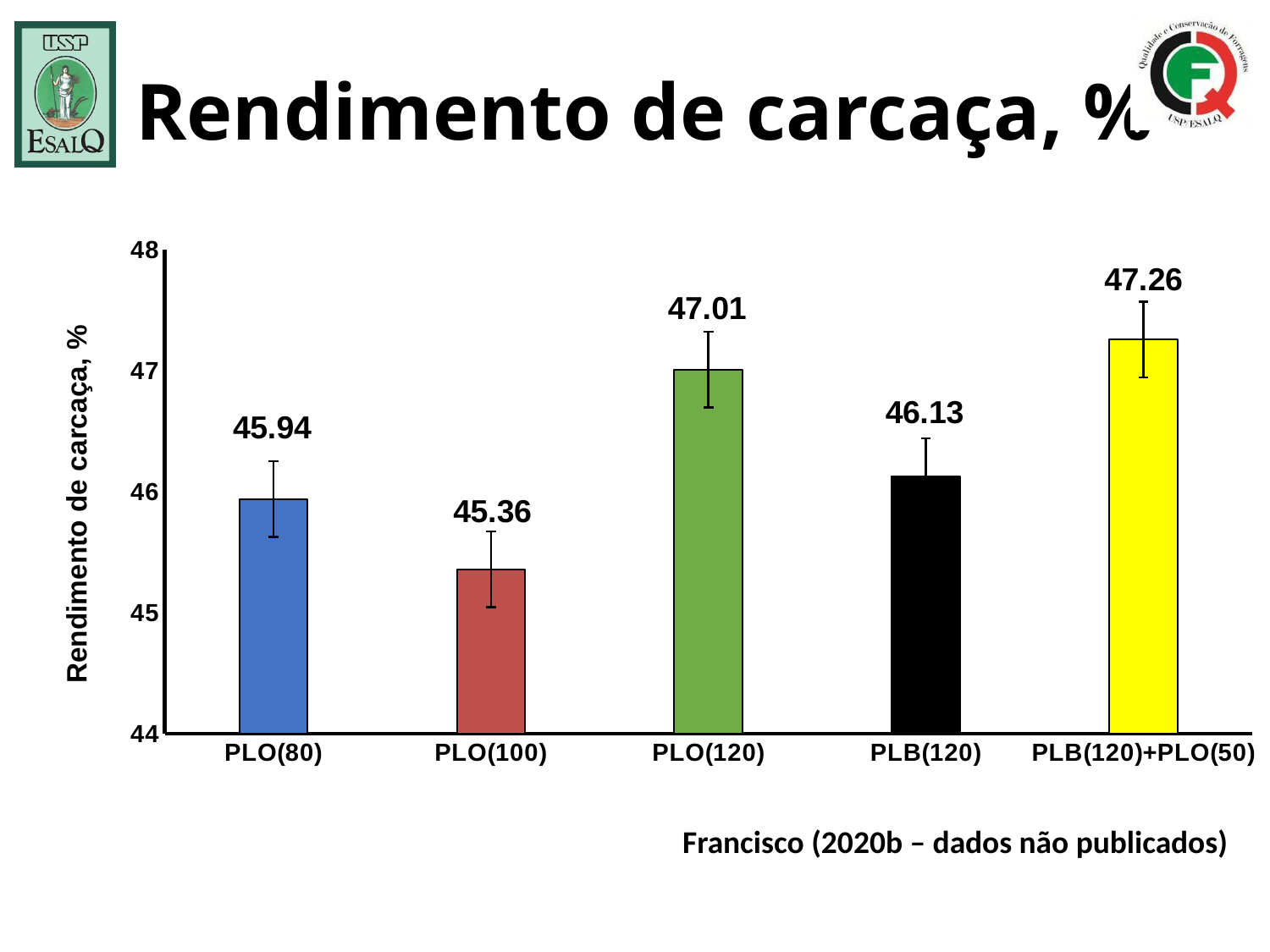
Which category has the lowest carcass yield? PLO(100) What kind of chart is shown on the slide? bar chart What is the value shown for PLB(120)+PLO(50)? 47.26 Is the value for PLO(120) greater or less than 47? greater Which category has the highest carcass yield? PLB(120)+PLO(50) How many categories are shown on the x axis? 5 What is the difference between the values for PLB(120)+PLO(50) and PLB(120)? 1.13 Which is larger, the value for PLO(80) or the value for PLB(120)? PLB(120) What is the label of the y axis? Rendimento de carcaça, % What is the carcass yield value for PLO(80)? 45.94 What is the value shown for PLB(120)? 46.13 What is the difference between the values for PLO(120) and PLO(100)? 1.65